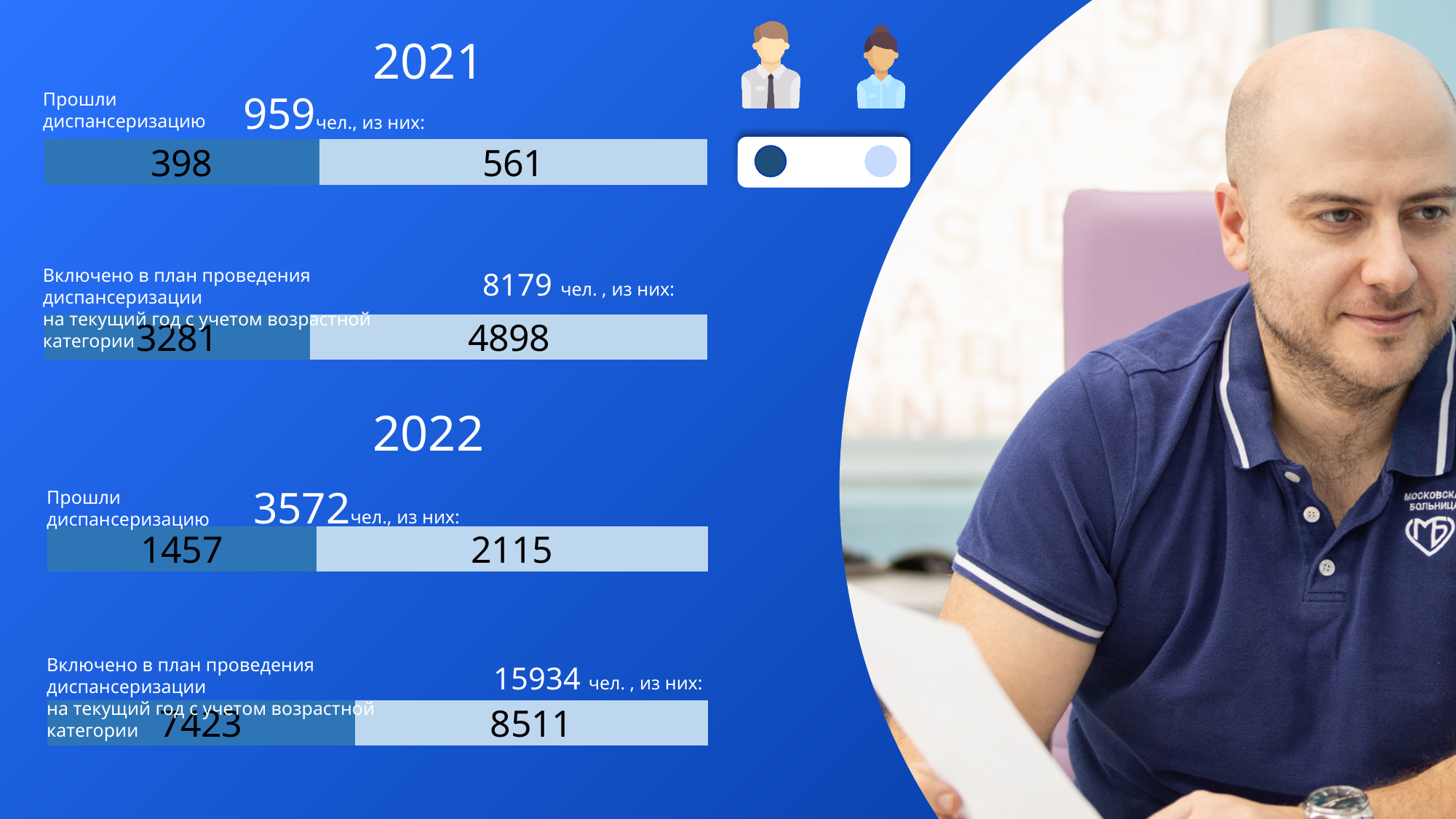
What is the total shown for the 2022 'Включено в план проведения диспансеризации' bar? 15934 In the 2022 'Прошли диспансеризацию' bar, what is the difference between the light blue and dark blue segments? 658 How many segments does each bar on the slide contain? 2 In the 2022 'Включено в план проведения диспансеризации' bar, what is the value of the dark blue segment? 7423 In the 2022 'Включено в план проведения диспансеризации' bar, which segment is larger, the dark blue or the light blue? light blue In the 2021 'Включено в план проведения диспансеризации' bar, what is the value of the light blue segment? 4898 What is the total shown for the 2021 'Прошли диспансеризацию' bar? 959 In the 2021 'Прошли диспансеризацию' bar, what is the value of the light blue segment? 561 In the 2021 'Прошли диспансеризацию' bar, what is the value of the dark blue segment? 398 What kind of chart is used to show the 'Прошли диспансеризацию' data for 2021? stacked bar chart What is the total shown for the 2021 'Включено в план проведения диспансеризации' bar? 8179 In the 2022 'Прошли диспансеризацию' bar, what is the value of the dark blue segment? 1457